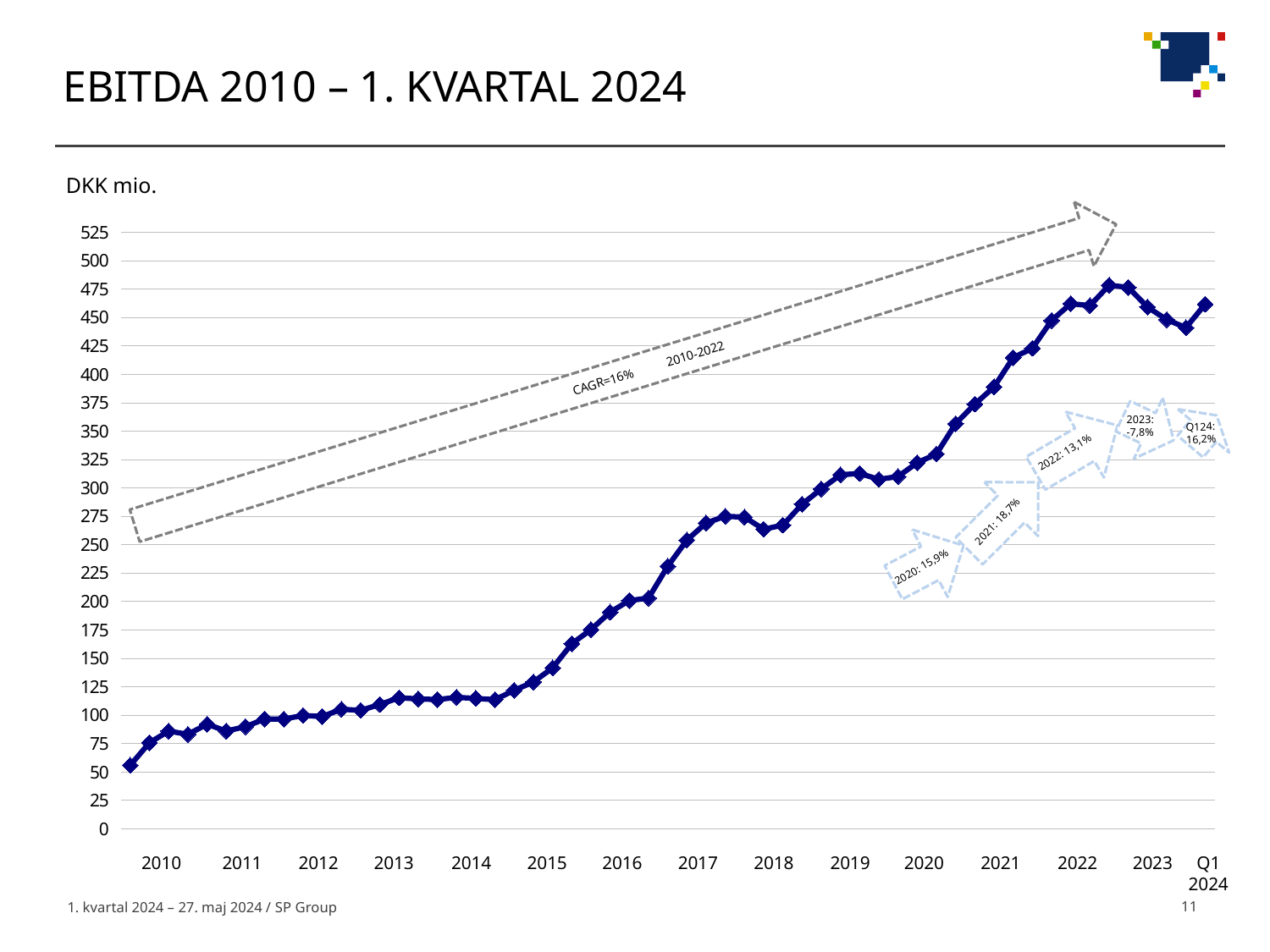
How many year labels are shown on the x axis, including Q1 2024? 15 What growth percentage is shown in the arrow for 2020? 15,9% Does the EBITDA line generally rise or fall from 2010 to 2022? rise What growth percentage is shown in the arrow for 2021? 18,7% What unit is shown above the y axis of the chart? DKK mio. What CAGR is stated for 2010-2022 on the chart? CAGR=16% What kind of chart is shown on the slide? line chart What growth percentage is shown in the arrow for 2023? -7,8% Is the EBITDA value at the start of 2010 greater or less than 75? less What is the title of the chart? EBITDA 2010 – 1. KVARTAL 2024 Is the peak EBITDA value reached in 2022 greater or less than 450? greater What growth percentage is shown in the arrow for Q1 2024 (Q124)? 16,2%